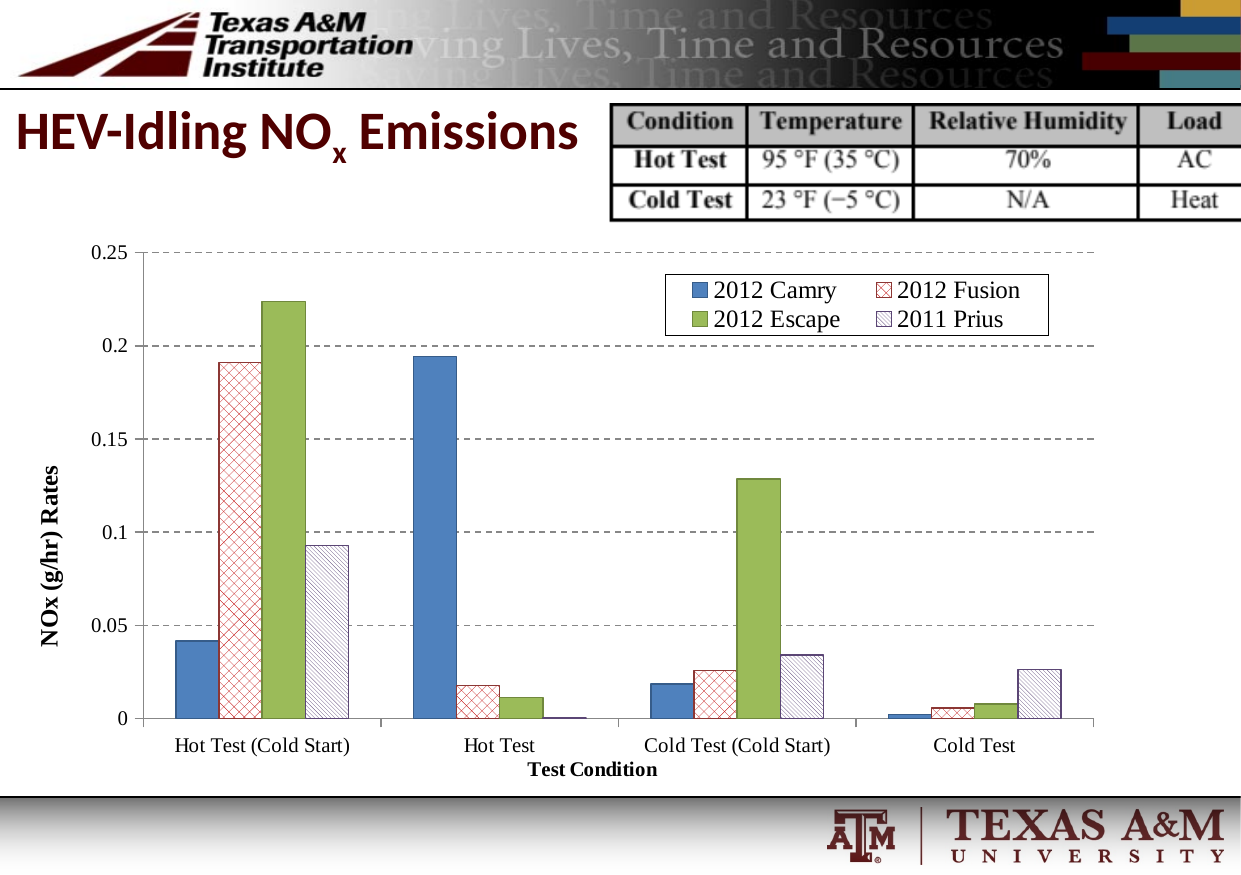
Which vehicle has the highest NOx rate under the Hot Test (Cold Start) condition? 2012 Escape Which vehicle has the lowest NOx rate under the Hot Test condition? 2011 Prius What kind of chart is shown on the slide? bar chart Which vehicle has the highest NOx rate under the Hot Test condition? 2012 Camry Which vehicle has the highest NOx rate under the Cold Test (Cold Start) condition? 2012 Escape Is the NOx rate for the 2012 Escape under Hot Test (Cold Start) greater or less than 0.2? greater How many series does the legend list? 4 How many test conditions are shown along the x axis? 4 Is the NOx rate for the 2012 Camry under the Hot Test condition greater or less than 0.15? greater What is the label on the y axis of the chart? NOx (g/hr) Rates Under the Hot Test (Cold Start) condition, which has the higher NOx rate, the 2012 Fusion or the 2011 Prius? 2012 Fusion